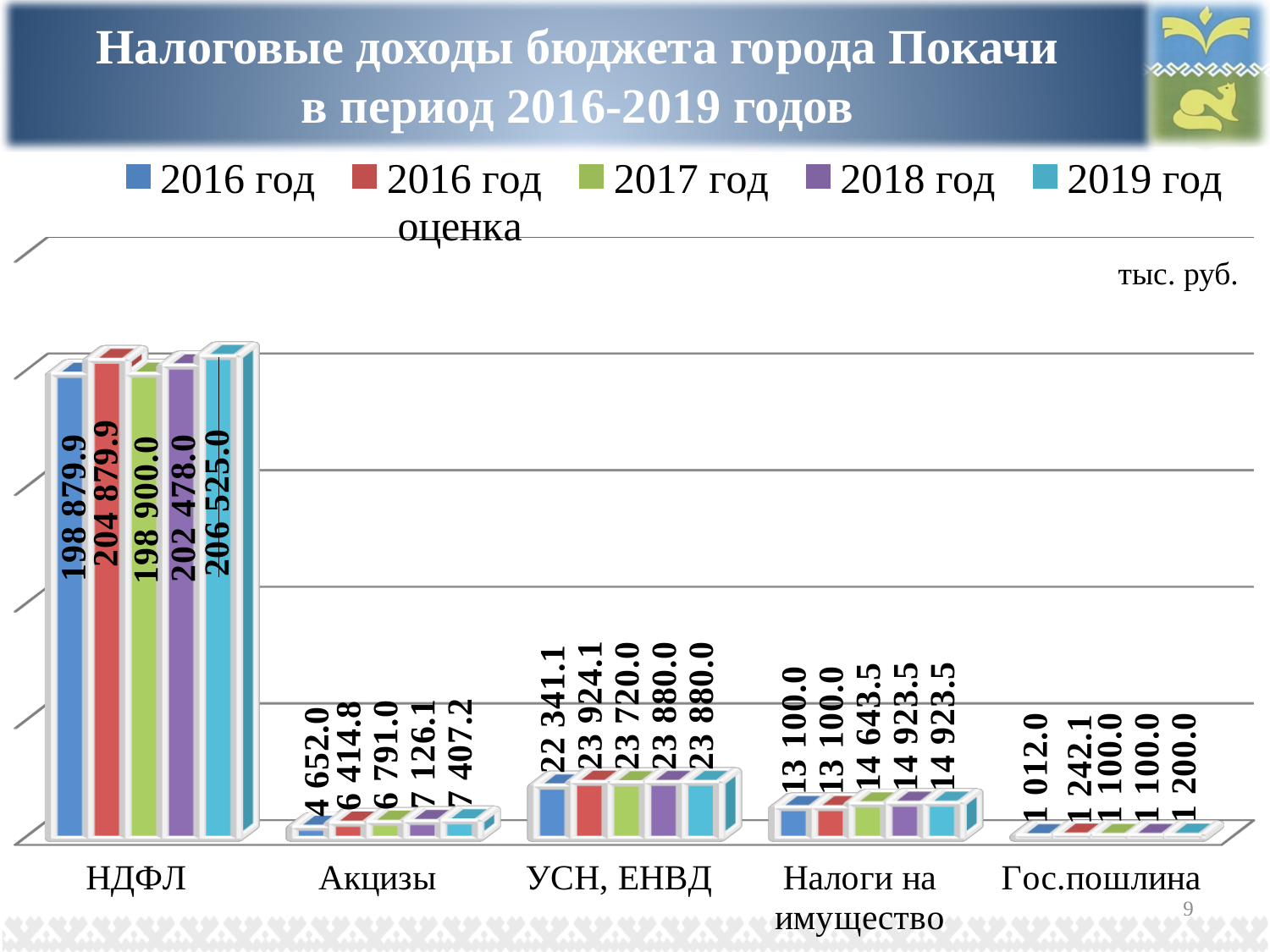
What is the value for Налоги на имущество in the 2017 год series? 14 643.5 What is the difference between the 2019 год and 2016 год оценка values for НДФЛ? 1 645.1 What unit is indicated for the values on the chart? тыс. руб. Which is larger for УСН, ЕНВД: the 2016 год оценка value or the 2017 год value? 2016 год оценка What type of chart is shown on the slide? bar chart How many categories are shown on the x axis? 5 Which category has the highest values across all series? НДФЛ What is the value for НДФЛ in the 2019 год series? 206 525.0 What is the value for Акцизы in the 2016 год оценка series? 6 414.8 Which category has the lowest values across all series? Гос.пошлина What is the value for Гос.пошлина in the 2018 год series? 1 100.0 How many series does the legend list? 5